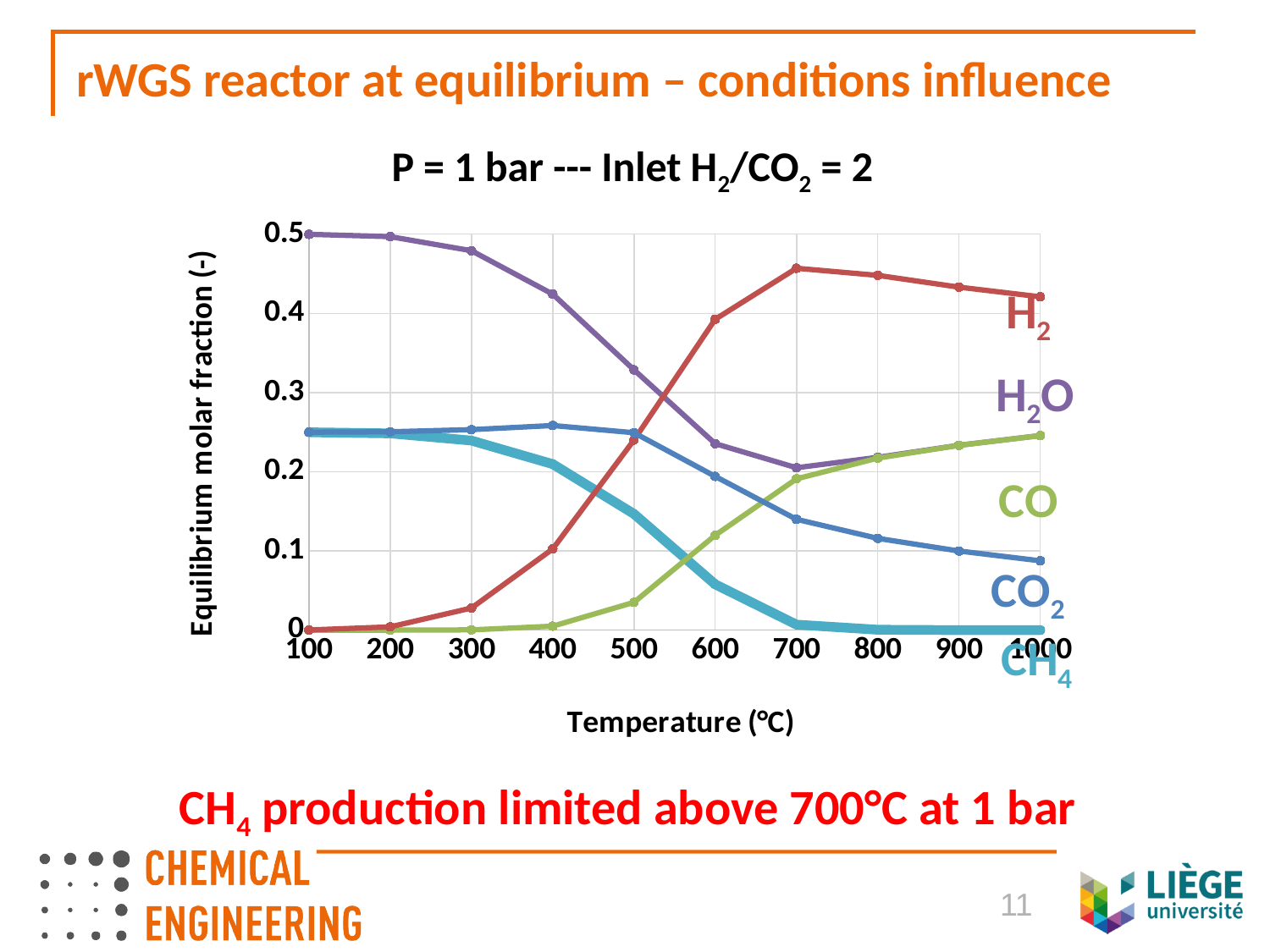
Which species has the highest equilibrium molar fraction at 1000°C? H2 Which species has the lowest equilibrium molar fraction at 1000°C? CH4 Is the value for H2 at 700°C greater or less than 0.4? greater Does the CO molar fraction rise or fall as temperature increases from 100°C to 1000°C? rise Which species has the highest equilibrium molar fraction at 100°C? H2O How many temperature points are marked on the x axis? 10 What is the label of the y axis? Equilibrium molar fraction (-) How many gas species are plotted as lines on the chart? 5 What is the title of the chart? P = 1 bar --- Inlet H2/CO2 = 2 What kind of chart is shown on the slide? line chart At 700°C, which is larger, the molar fraction of H2 or of H2O? H2 Is the value for CO2 at 1000°C greater or less than 0.1? less